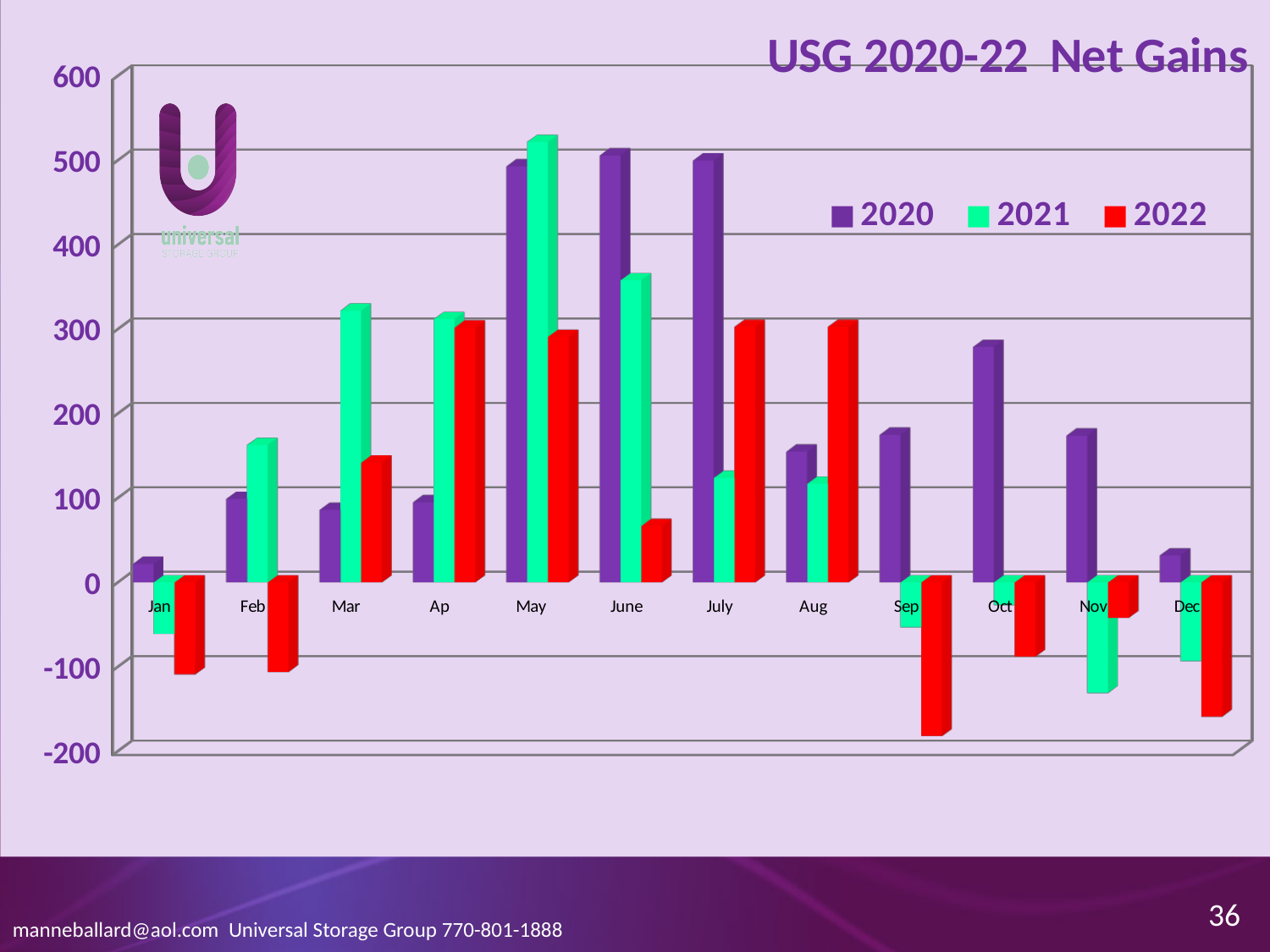
Do the 2020 values rise or fall from Jan to May? rise What kind of chart is shown on the slide? bar chart In which month is the 2021 value highest? May How many series does the legend list? 3 Which colour represents the 2022 series in the legend? red Is the 2020 value for Dec greater or less than 100? less Is the 2020 value for Oct greater or less than 200? greater Is the 2021 value for May greater or less than 500? greater How many months are shown along the x axis? 12 For June, which series has the larger value, 2020 or 2021? 2020 What is the title of the chart? USG 2020-22 Net Gains